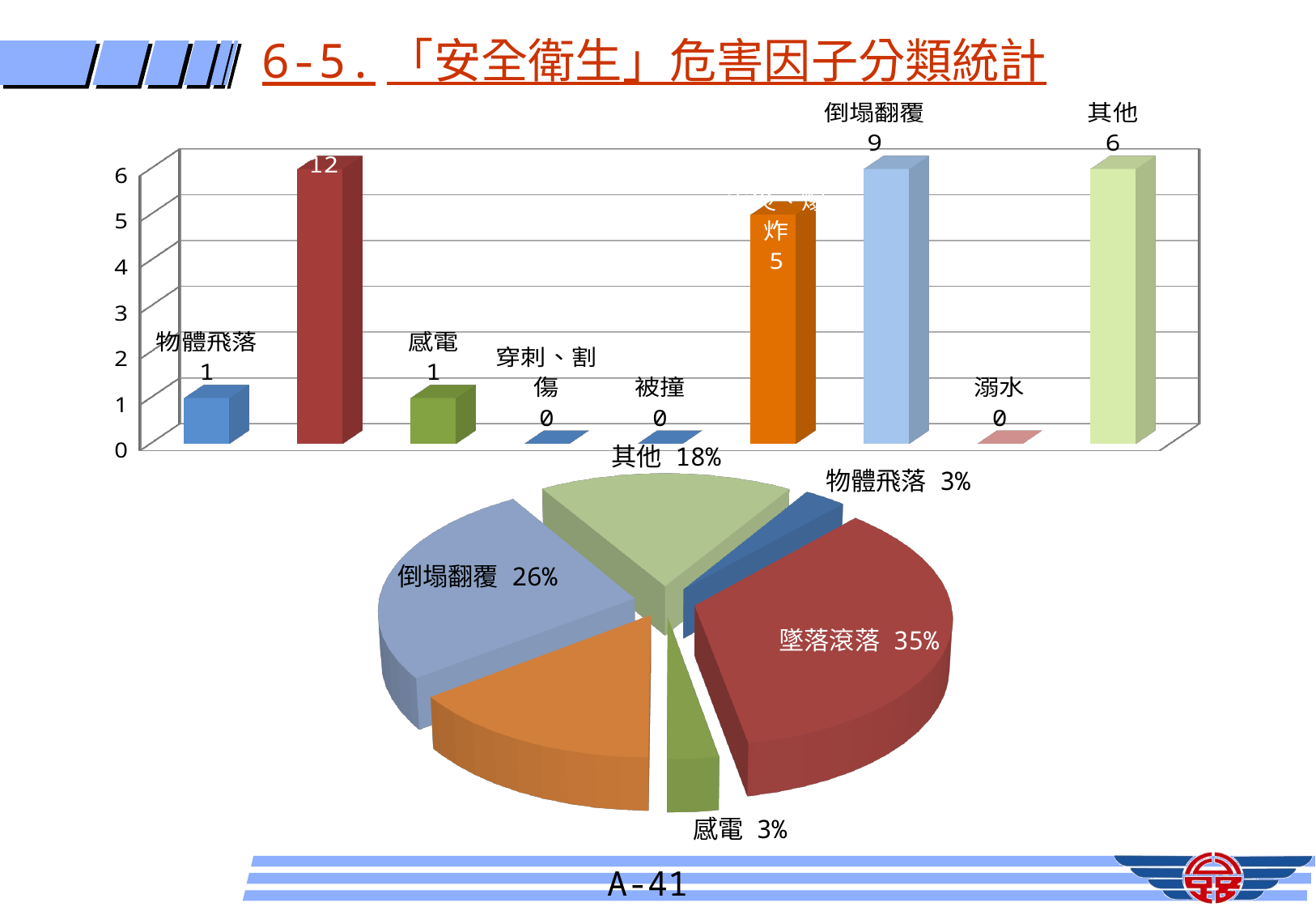
In the bar chart, what is the value for 倒塌翻覆? 9 What kind of chart is shown at the bottom of the slide? Pie chart How many bars are plotted in the bar chart? 9 In the pie chart, what share does 倒塌翻覆 have? 26% In the bar chart, what is the value for 物體飛落? 1 In the pie chart, which labeled slice has the largest share? 墜落滾落 In the bar chart, what is the value for 其他? 6 In the bar chart, which is larger, the value for 感電 or the value for 倒塌翻覆? 倒塌翻覆 In the pie chart, what share does 墜落滾落 have? 35% In the bar chart, what is the difference between the values for 倒塌翻覆 and 其他? 3 In the bar chart, what is the value for 溺水? 0 In the bar chart, what is the highest data label shown on any bar? 12